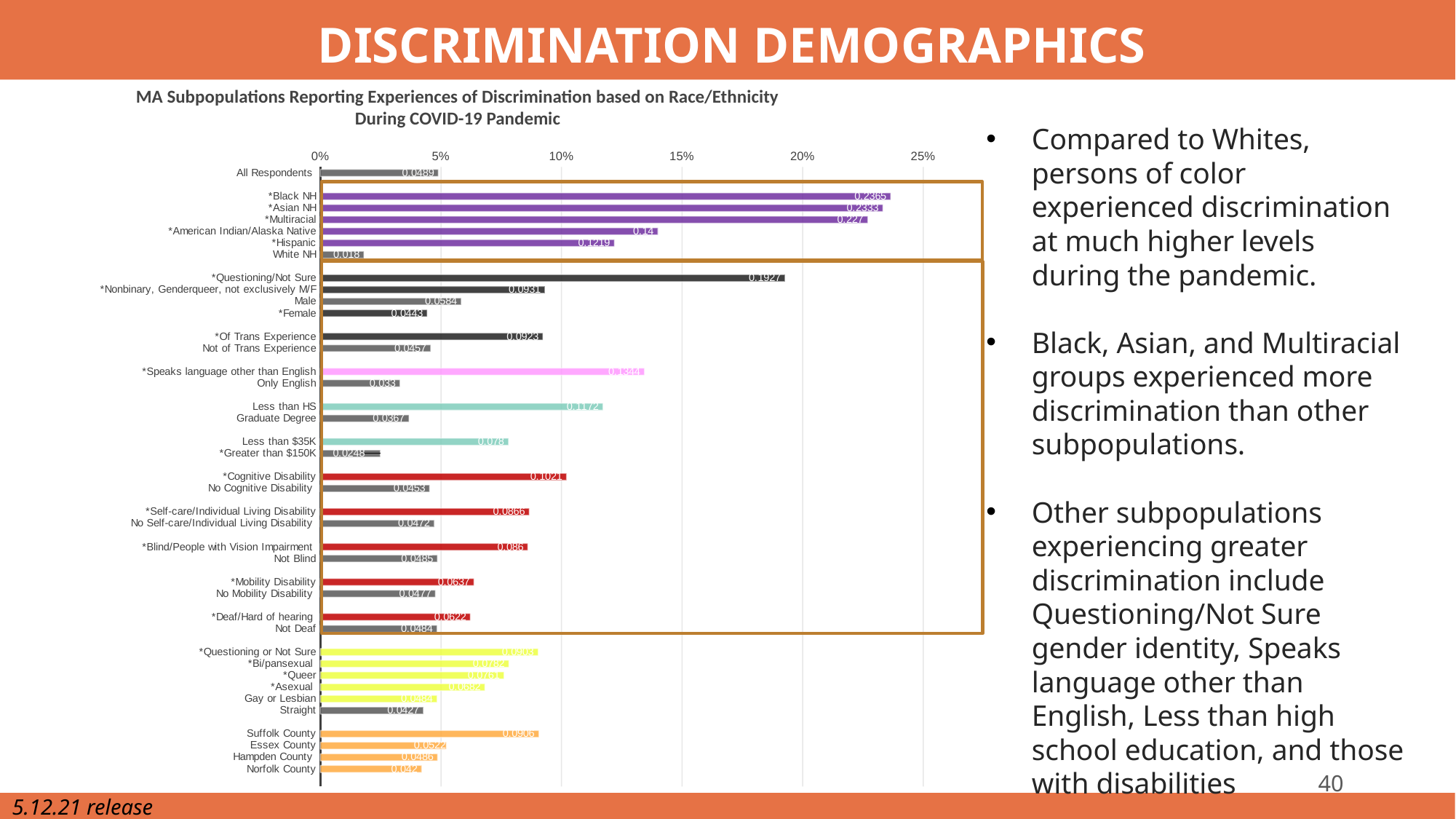
What is the value for *Questioning/Not Sure? 0.1927 What is the difference between the values for *Black NH and White NH? 0.2185 What is the value for All Respondents? 0.0489 What is the value for *Black NH? 0.2365 Which has a larger value, Male or *Female? Male What type of chart is shown on the slide? bar chart How many county categories are shown in the chart? 4 What is the value for Suffolk County? 0.0906 Is the value for *Speaks language other than English greater or less than 10%? greater What is the value for White NH? 0.018 Which category has the lowest value in the chart? White NH Which category has the highest value in the chart? *Black NH